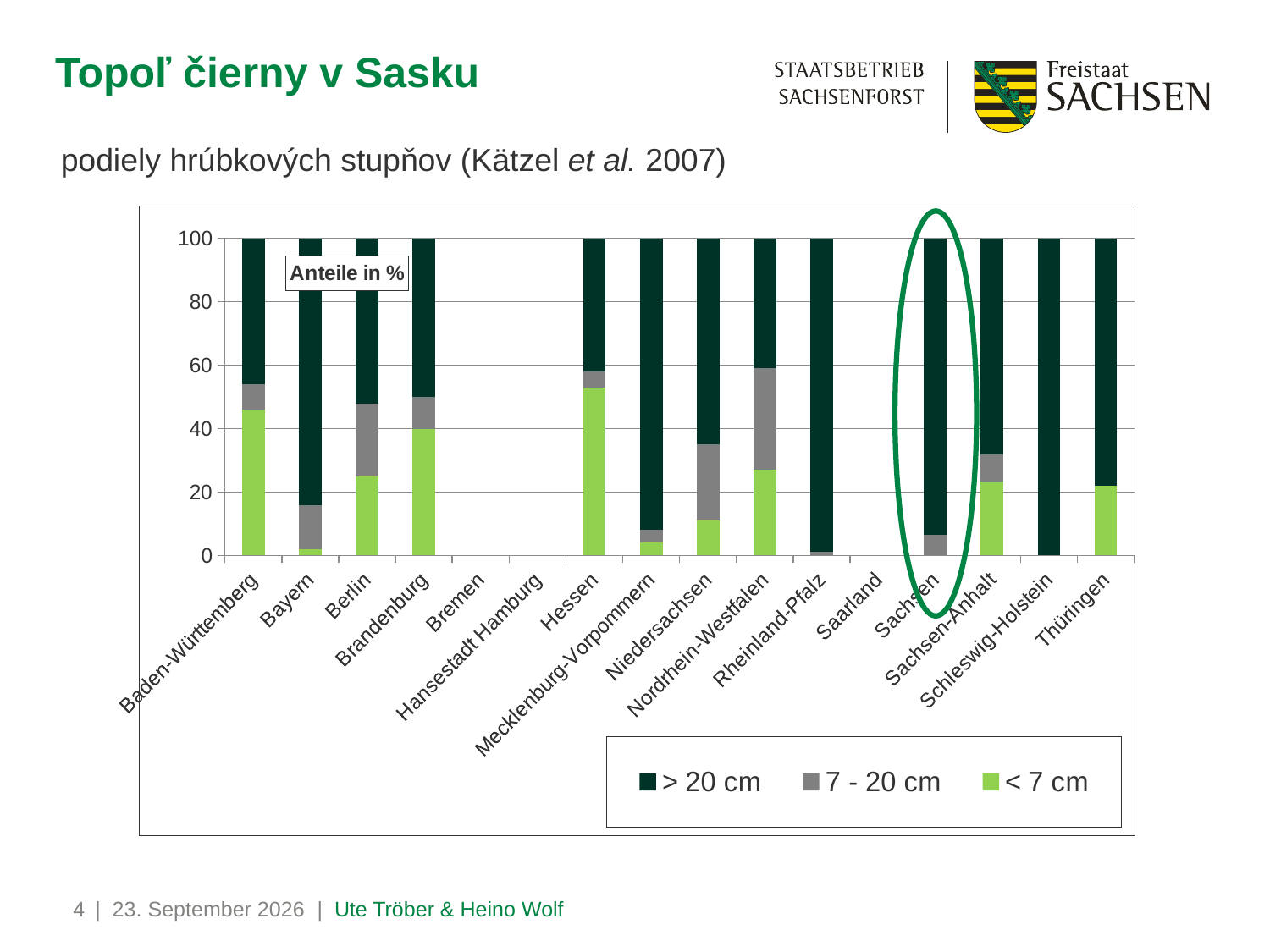
How many series does the legend list? 3 Which categories have no bar plotted at all? Bremen, Hansestadt Hamburg, Saarland What kind of chart is shown on the slide? stacked bar chart Is the value of the < 7 cm segment for Hessen greater or less than 40? greater What is the total height of the stacked bar for Bayern? 100 Which has the larger 7 - 20 cm segment, Berlin or Brandenburg? Berlin Which category on the chart is highlighted with a green ellipse? Sachsen How many categories are shown on the x axis? 16 Which category has the largest 7 - 20 cm segment? Nordrhein-Westfalen Is the combined height of the < 7 cm and 7 - 20 cm segments for Sachsen greater or less than 20? less Is the value of the < 7 cm segment for Baden-Württemberg greater or less than 40? greater Which has the larger < 7 cm segment, Hessen or Bayern? Hessen